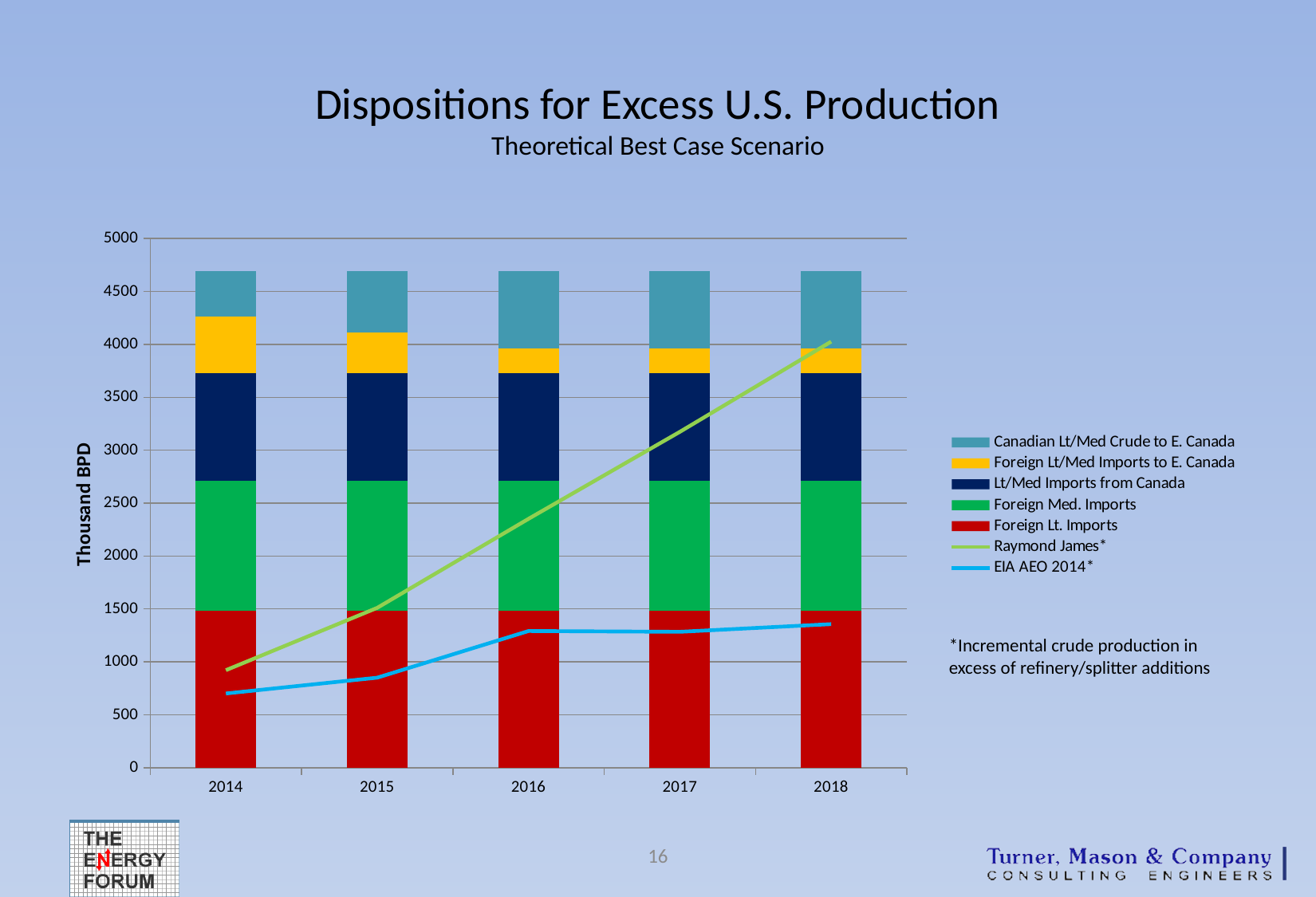
Is the EIA AEO 2014* value for 2018 greater or less than 1000? greater How many years are shown along the x axis of the chart? 5 What is the title of the chart on the slide? Dispositions for Excess U.S. Production Does the Raymond James* line rise or fall from 2014 to 2018? Rises Is the total height of the stacked bar for 2016 greater or less than 4500? greater In which year is the Foreign Lt/Med Imports to E. Canada segment the largest? 2014 What kind of chart is used to show the disposition categories (Foreign Lt. Imports, Foreign Med. Imports, etc.)? Stacked bar chart In 2018, which is larger: the Raymond James* value or the EIA AEO 2014* value? Raymond James* Is the Raymond James* value for 2017 greater or less than 3000? greater How many series does the chart's legend list? 7 What is the label on the vertical axis of the chart? Thousand BPD